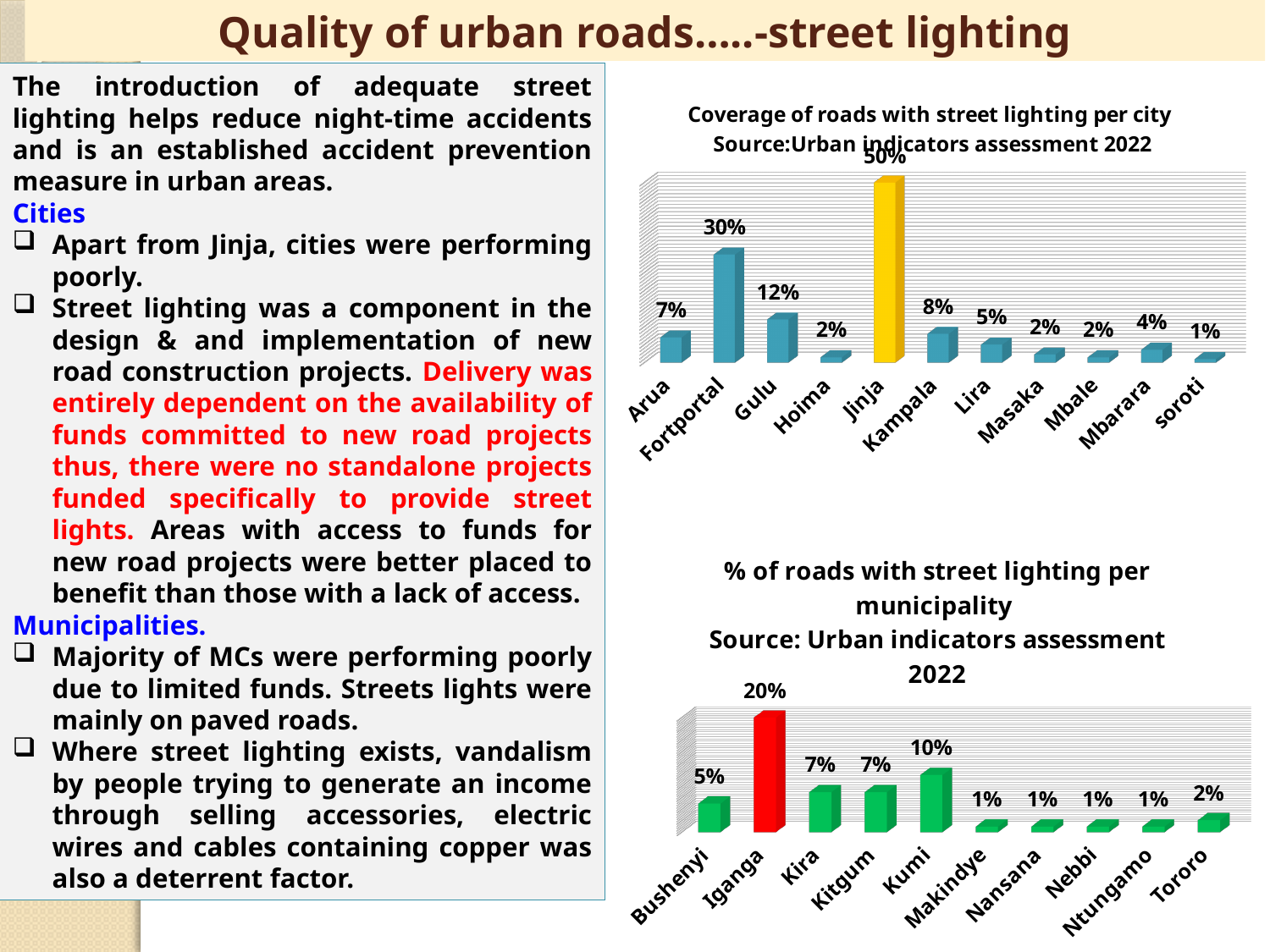
In the '% of roads with street lighting per municipality' chart, what is the value for Iganga? 20% How many municipalities are shown in the '% of roads with street lighting per municipality' chart? 10 In the 'Coverage of roads with street lighting per city' chart, what is the value for Jinja? 50% In the 'Coverage of roads with street lighting per city' chart, which is larger, Gulu or Kampala? Gulu What type of chart is the '% of roads with street lighting per municipality' chart? Bar chart In the 'Coverage of roads with street lighting per city' chart, what is the value for Fortportal? 30% In the '% of roads with street lighting per municipality' chart, what is the value for Kumi? 10% In the 'Coverage of roads with street lighting per city' chart, which city has the lowest value? soroti In the 'Coverage of roads with street lighting per city' chart, what is the difference between Jinja and Fortportal? 20% In the '% of roads with street lighting per municipality' chart, which municipality has the highest value? Iganga How many cities are shown in the 'Coverage of roads with street lighting per city' chart? 11 In the 'Coverage of roads with street lighting per city' chart, which city has the highest value? Jinja